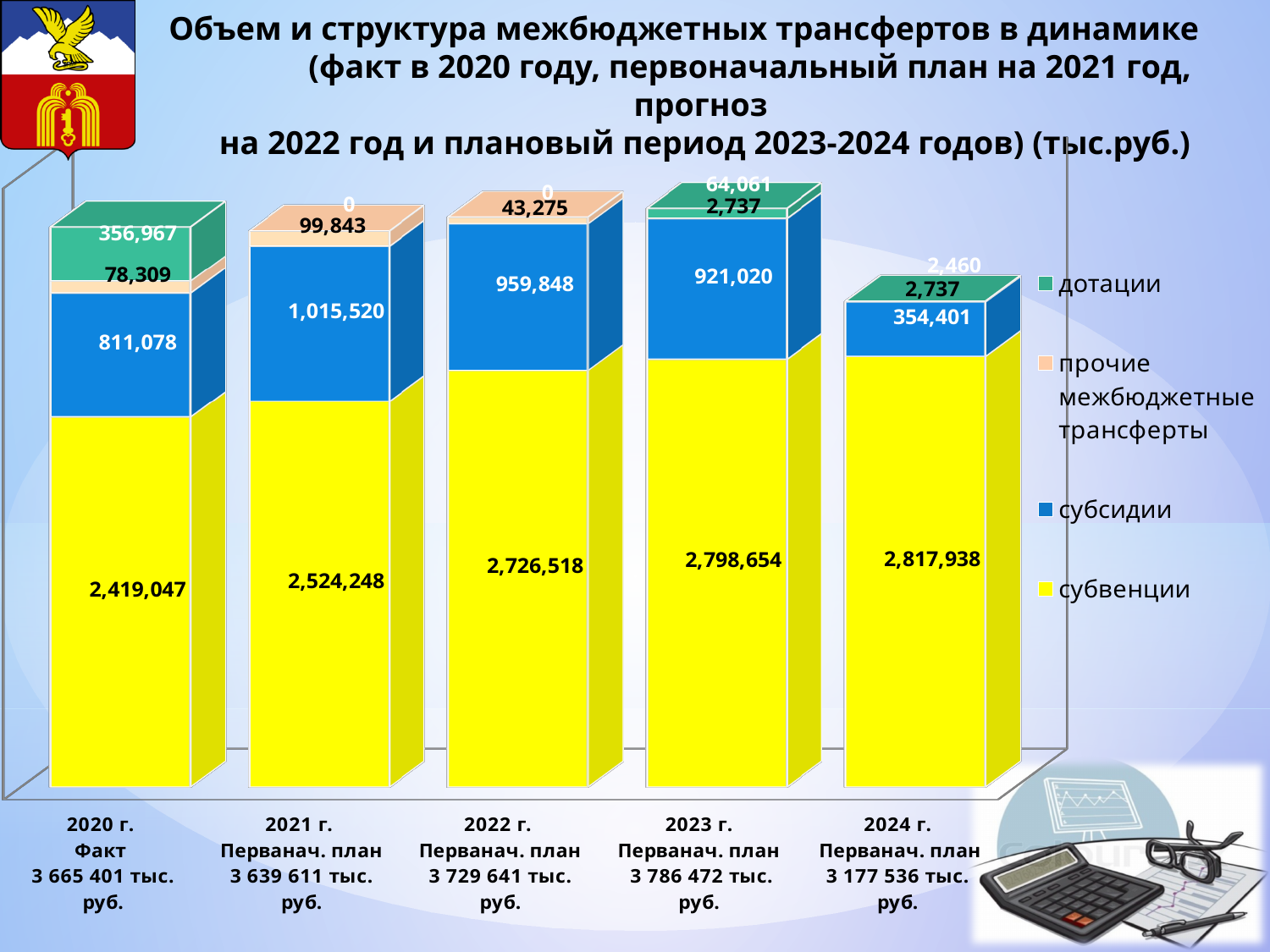
Do the values of субвенции rise or fall from 2020 to 2024? Rise What is the value of субвенции for 2020 г.? 2,419,047 How many series does the legend list? 4 What is the value of субсидии for 2021 г.? 1,015,520 What is the difference between субсидии in 2022 г. and 2023 г.? 38,828 Which is larger: субсидии in 2020 г. or in 2024 г.? 2020 г. In which year is the value of субвенции the highest? 2024 г. What is the total of the stacked bar for 2023 г.? 3 786 472 тыс. руб. In which year is the value of субсидии the lowest? 2024 г. What is the value of прочие межбюджетные трансферты for 2022 г.? 43,275 How many years (bars) are shown in the chart? 5 What kind of chart is shown on the slide? Stacked bar chart